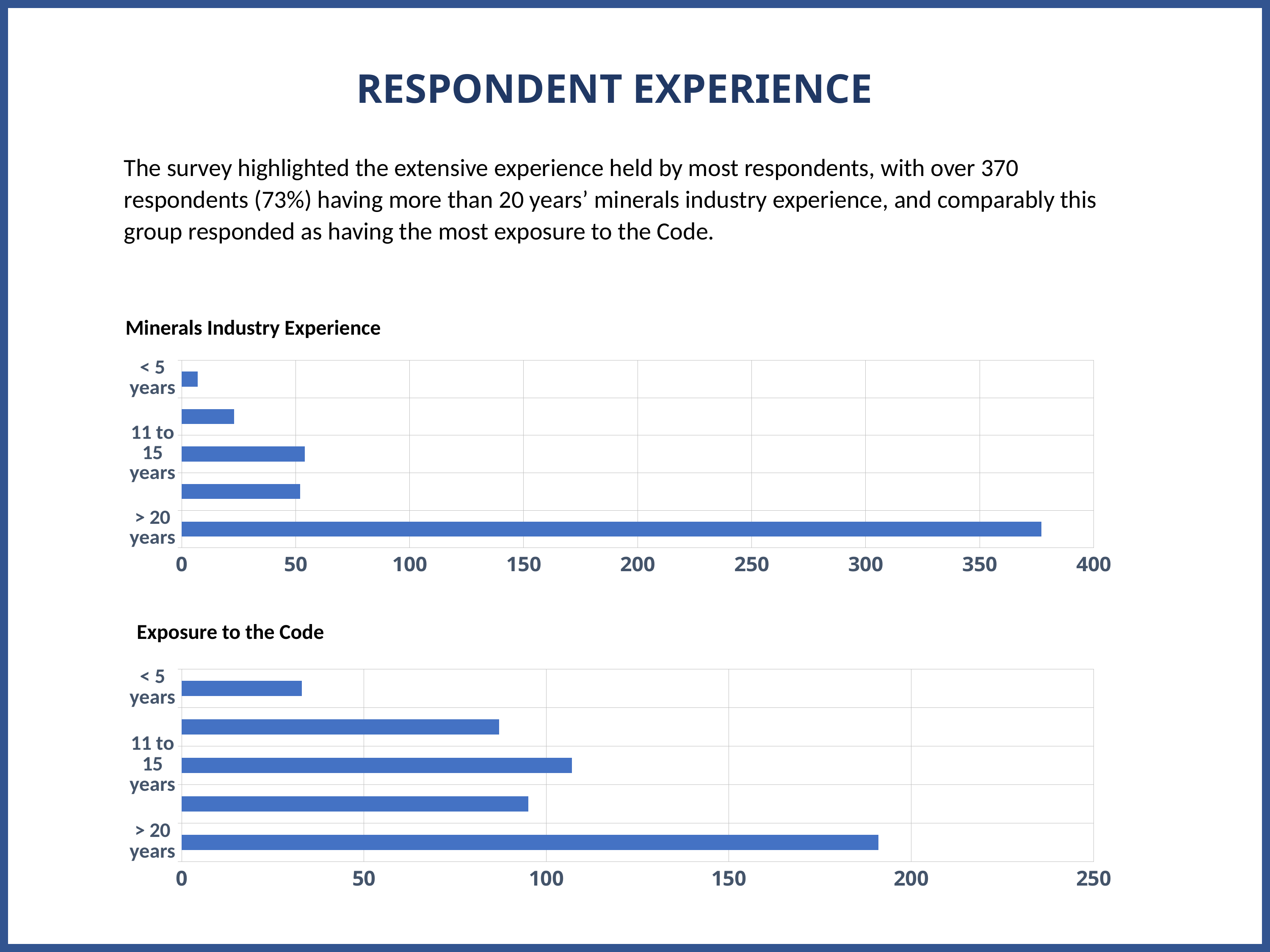
In the Minerals Industry Experience chart, which category has the highest value? > 20 years In the Minerals Industry Experience chart, is the value for > 20 years greater or less than 350? greater In the Exposure to the Code chart, which category has the highest value? > 20 years In the Exposure to the Code chart, is the value for > 20 years greater or less than 200? less How many bars are plotted in the Minerals Industry Experience chart? 5 What is the maximum value shown on the x axis of the Exposure to the Code chart? 250 In the Exposure to the Code chart, which is larger, the value for < 5 years or the value for 11 to 15 years? 11 to 15 years In the Exposure to the Code chart, is the value for 11 to 15 years greater or less than 100? greater In the Exposure to the Code chart, which category has the lowest value? < 5 years What kind of chart is the Minerals Industry Experience chart? bar chart In the Minerals Industry Experience chart, which category has the lowest value? < 5 years